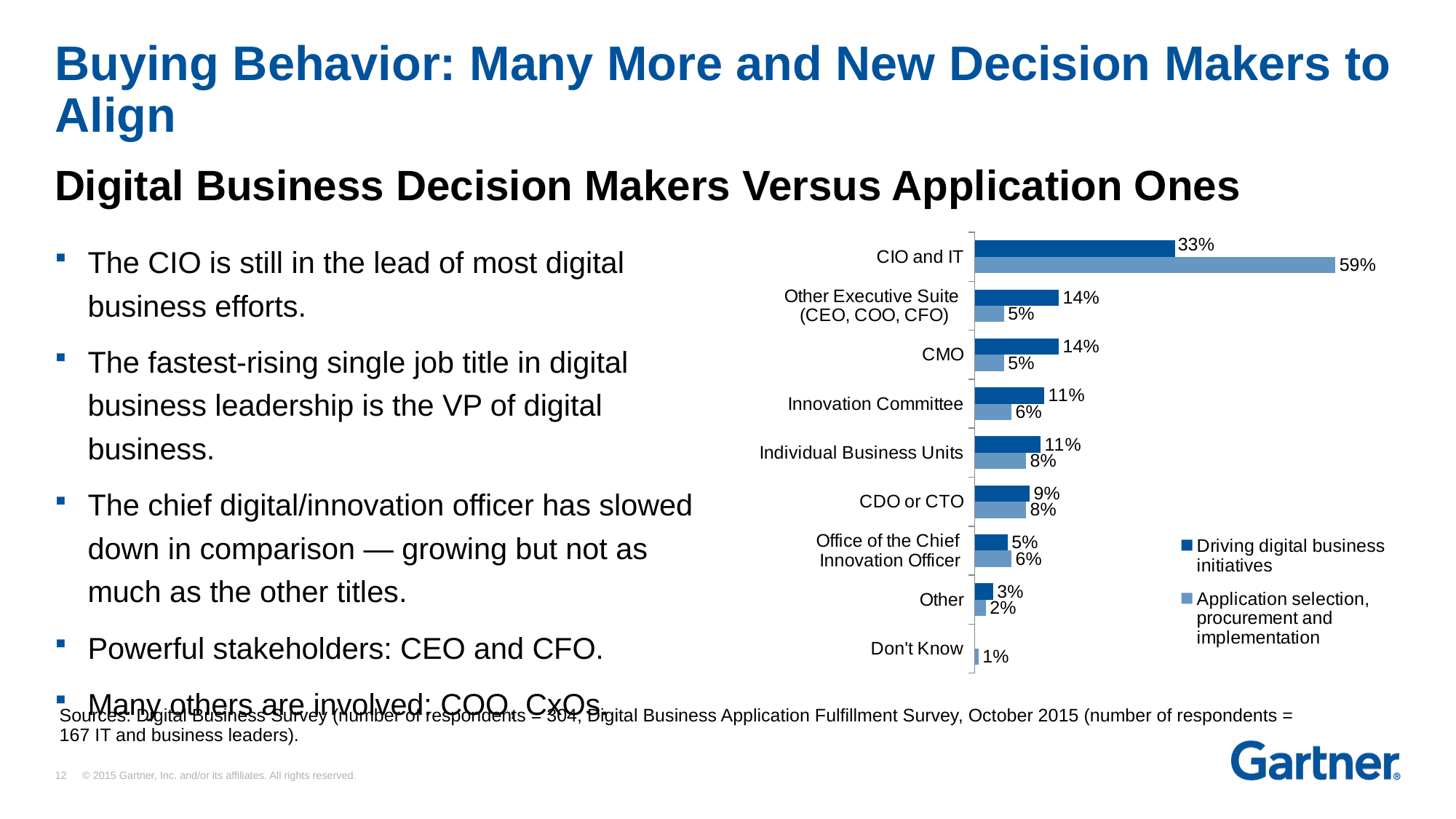
How many series does the chart legend list? 2 What is the value for CIO and IT in the Driving digital business initiatives series? 33% How many categories are shown on the chart? 9 What is the difference between the two series values for CIO and IT? 26% What is the value for CMO in the Driving digital business initiatives series? 14% What is the value for Individual Business Units in the Application selection, procurement and implementation series? 8% What is the value for CIO and IT in the Application selection, procurement and implementation series? 59% Which category has the lowest value in the Application selection, procurement and implementation series? Don't Know What is the difference between the Driving digital business initiatives value and the Application selection, procurement and implementation value for Other Executive Suite (CEO, COO, CFO)? 9% Which category has the highest value in the Application selection, procurement and implementation series? CIO and IT What kind of chart is shown on the slide? bar chart For Office of the Chief Innovation Officer, which series has the larger value: Driving digital business initiatives or Application selection, procurement and implementation? Application selection, procurement and implementation